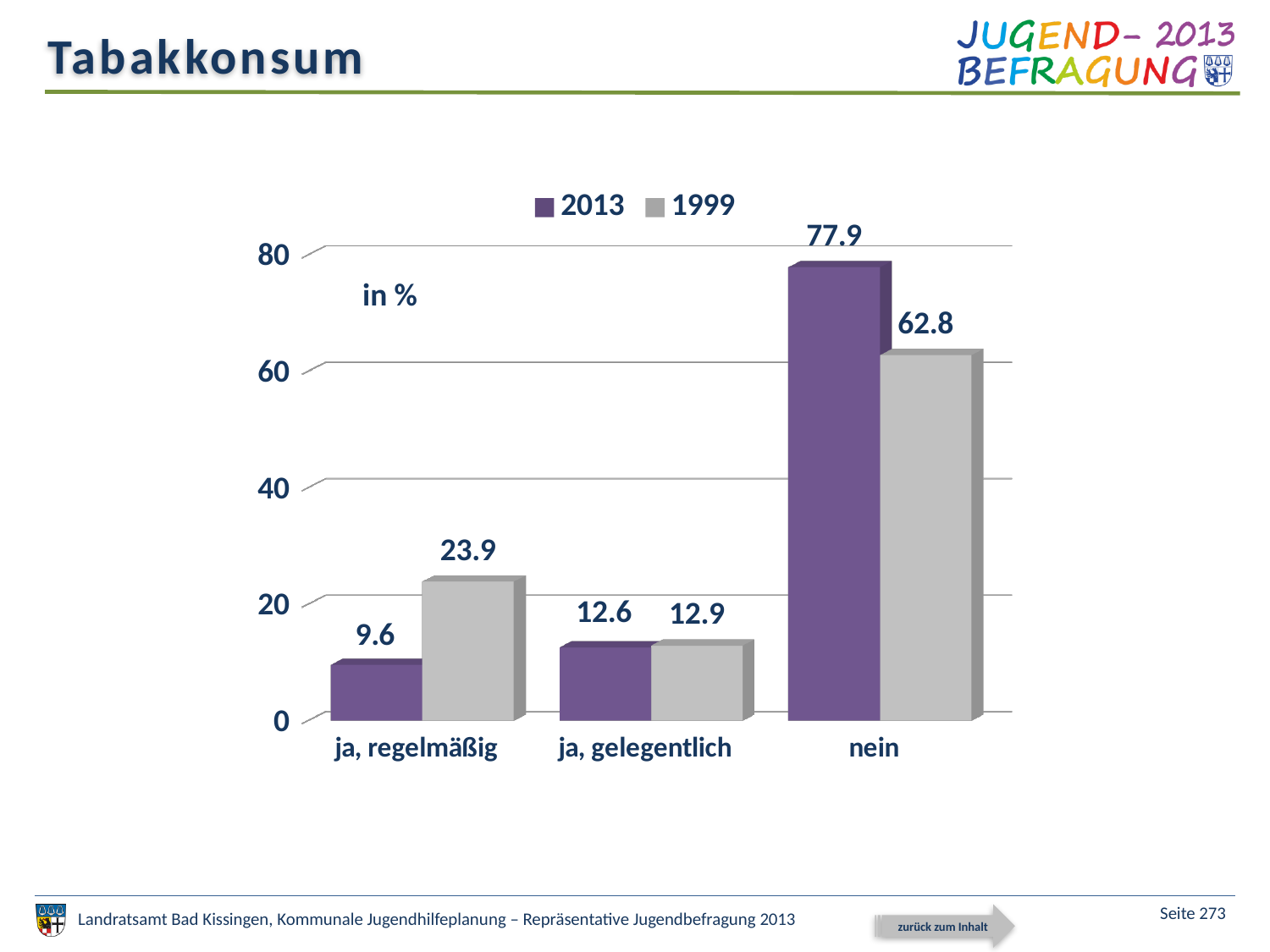
For "ja, regelmäßig", which series has the larger value, 2013 or 1999? 1999 What is the difference between the 1999 and 2013 values for "ja, regelmäßig"? 14.3 How many categories are shown on the x axis? 3 How many series does the legend list? 2 Which category has the highest value in the 1999 series? nein What kind of chart is shown on the slide? bar chart What is the value for "ja, regelmäßig" in the 1999 series? 23.9 Which category has the lowest value in the 2013 series? ja, regelmäßig What is the value for "ja, gelegentlich" in the 2013 series? 12.6 What is the value for "nein" in the 2013 series? 77.9 Is the 1999 value for "nein" greater or less than 60? greater What is the difference between the 2013 and 1999 values for "nein"? 15.1